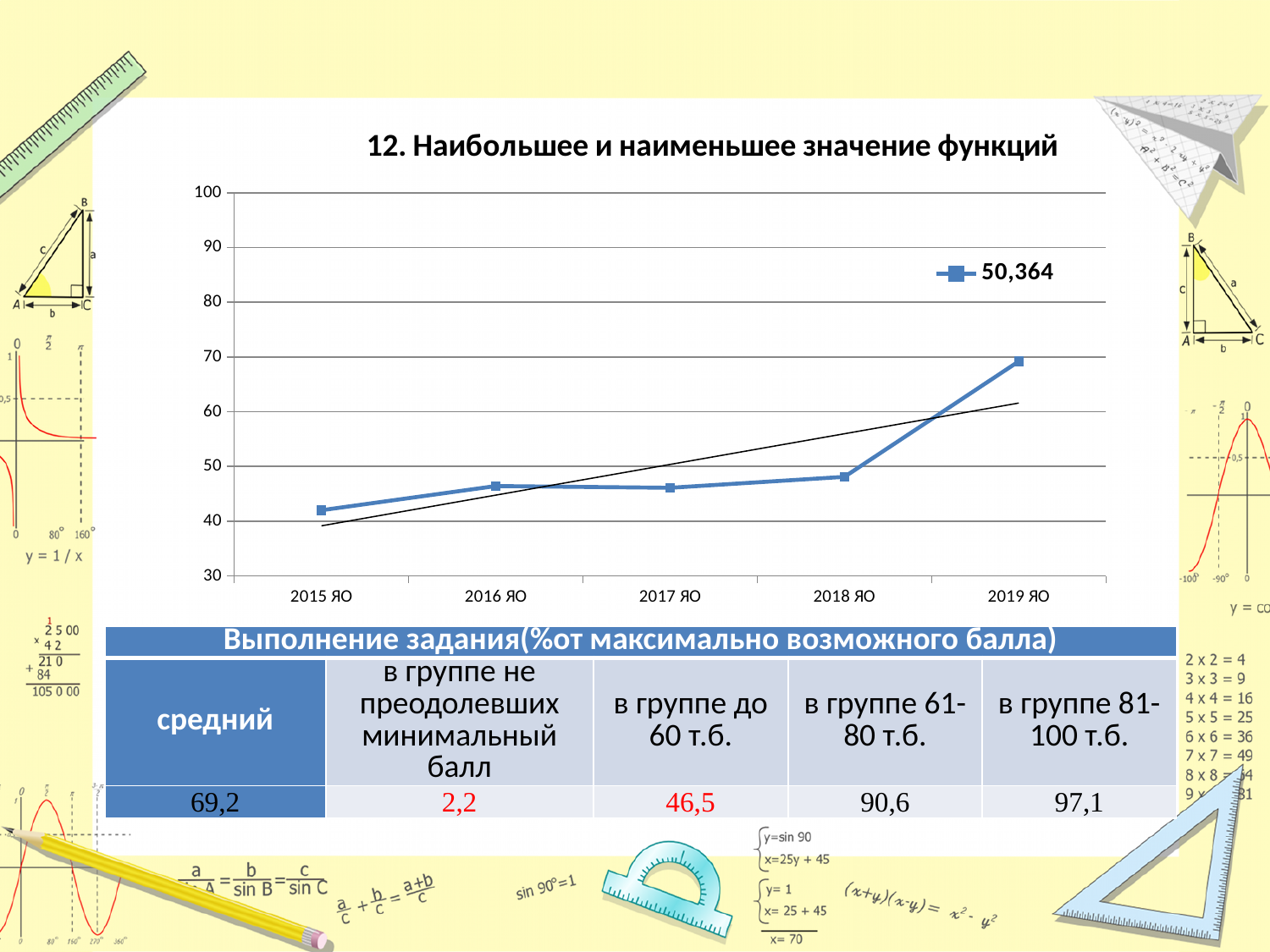
Do the values generally rise or fall from 2015 ЯО to 2019 ЯО? rise What kind of chart is shown on the slide? line chart Is the value for 2017 ЯО greater or less than 50? less How many data points are plotted along the x axis of the chart? 5 Which category has the lowest value on the chart? 2015 ЯО Is the value for 2015 ЯО greater or less than 50? less Which is larger, the value for 2018 ЯО or the value for 2019 ЯО? 2019 ЯО Which category has the highest value on the chart? 2019 ЯО How many series does the chart legend list? 1 Is the value for 2019 ЯО greater or less than 60? greater What is the title of the chart? 12. Наибольшее и наименьшее значение функций What entry is shown in the chart legend? 50,364